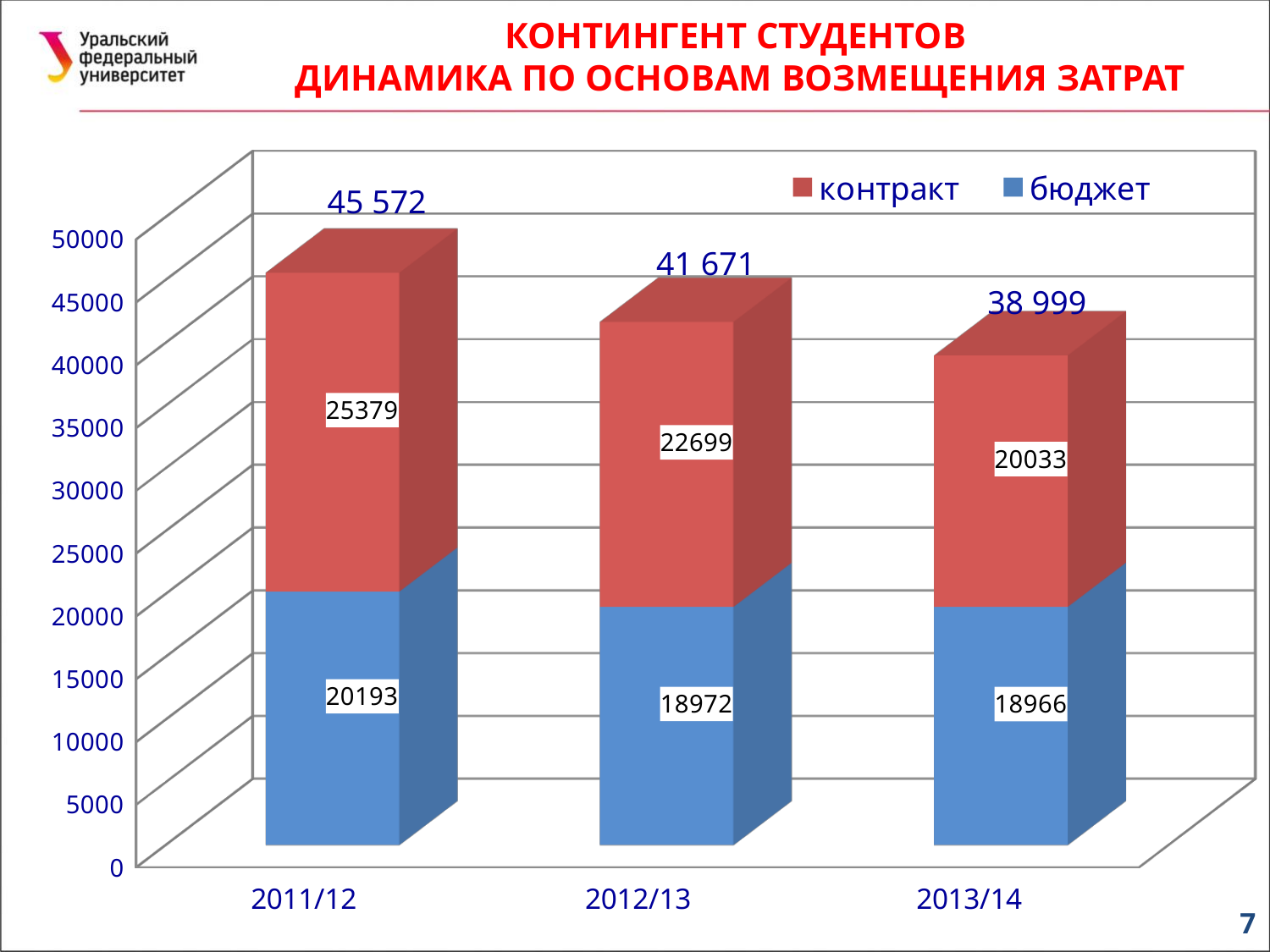
What is the total of the stacked bar for 2012/13? 41 671 What is the value for бюджет in 2011/12? 20193 What is the value for контракт in 2013/14? 20033 Which year has the lowest stacked total? 2013/14 How many years are shown on the x axis? 3 Which is larger in 2012/13: контракт or бюджет? контракт Do the stacked totals rise or fall from 2011/12 to 2013/14? fall Which year has the highest value for контракт? 2011/12 What is the value for контракт in 2012/13? 22699 What is the difference between the контракт values for 2011/12 and 2013/14? 5346 How many series does the legend list? 2 What is the total of the stacked bar for 2013/14? 38 999